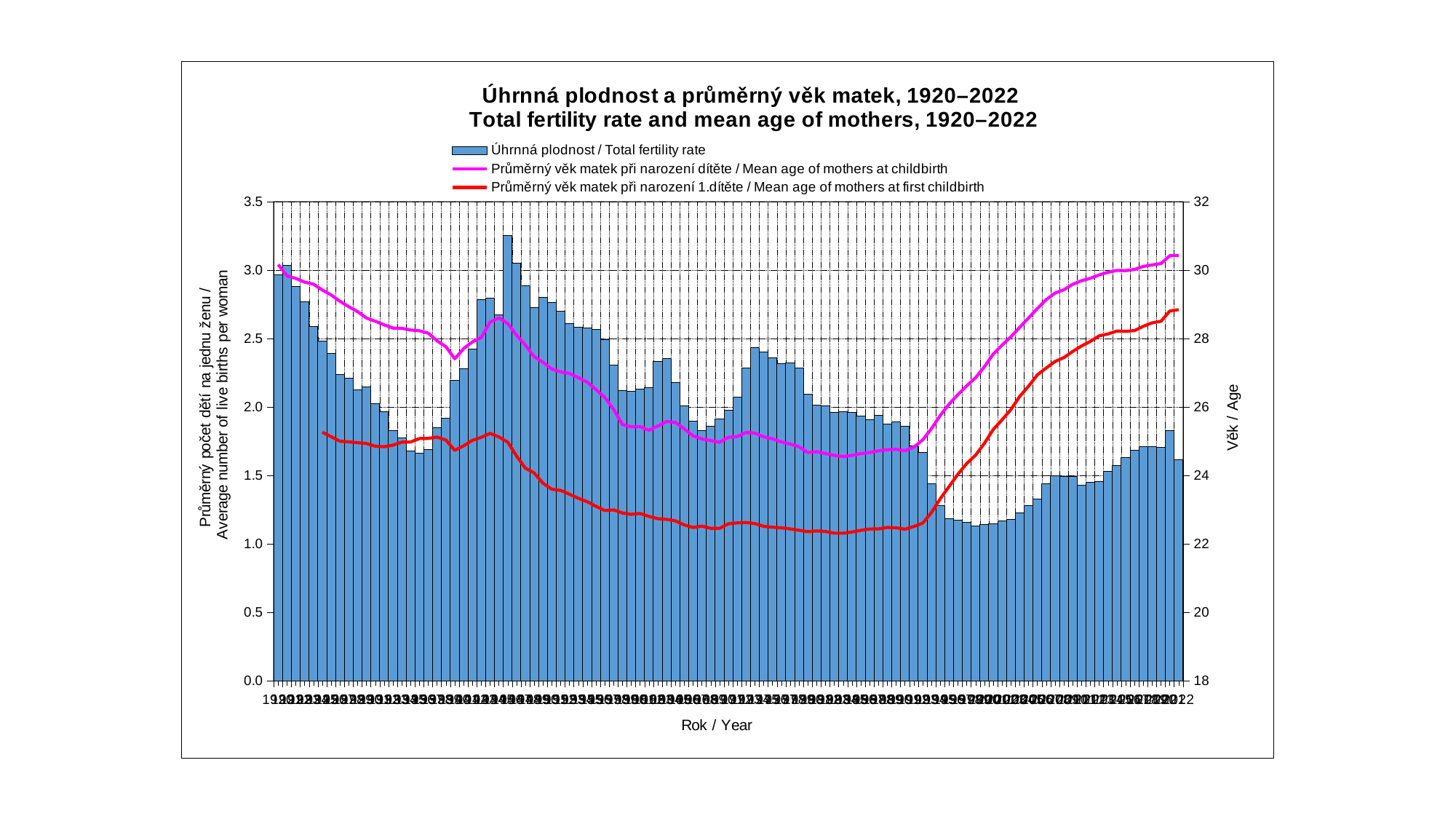
Which series is drawn as bars? Úhrnná plodnost / Total fertility rate In 2022, which is higher: the mean age of mothers at childbirth or the mean age of mothers at first childbirth? Mean age of mothers at childbirth What colour is the line for the mean age of mothers at first childbirth? Red Is the total fertility rate for 2022 greater or less than 2.0? less What kind of chart is shown on the slide? A bar chart combined with two line series Is the mean age of mothers at childbirth in 1920 greater or less than 28? greater Is the highest total fertility rate bar on the chart greater or less than 3.0? greater Which year has the higher total fertility rate, 1920 or 2022? 1920 How many series does the legend list? 3